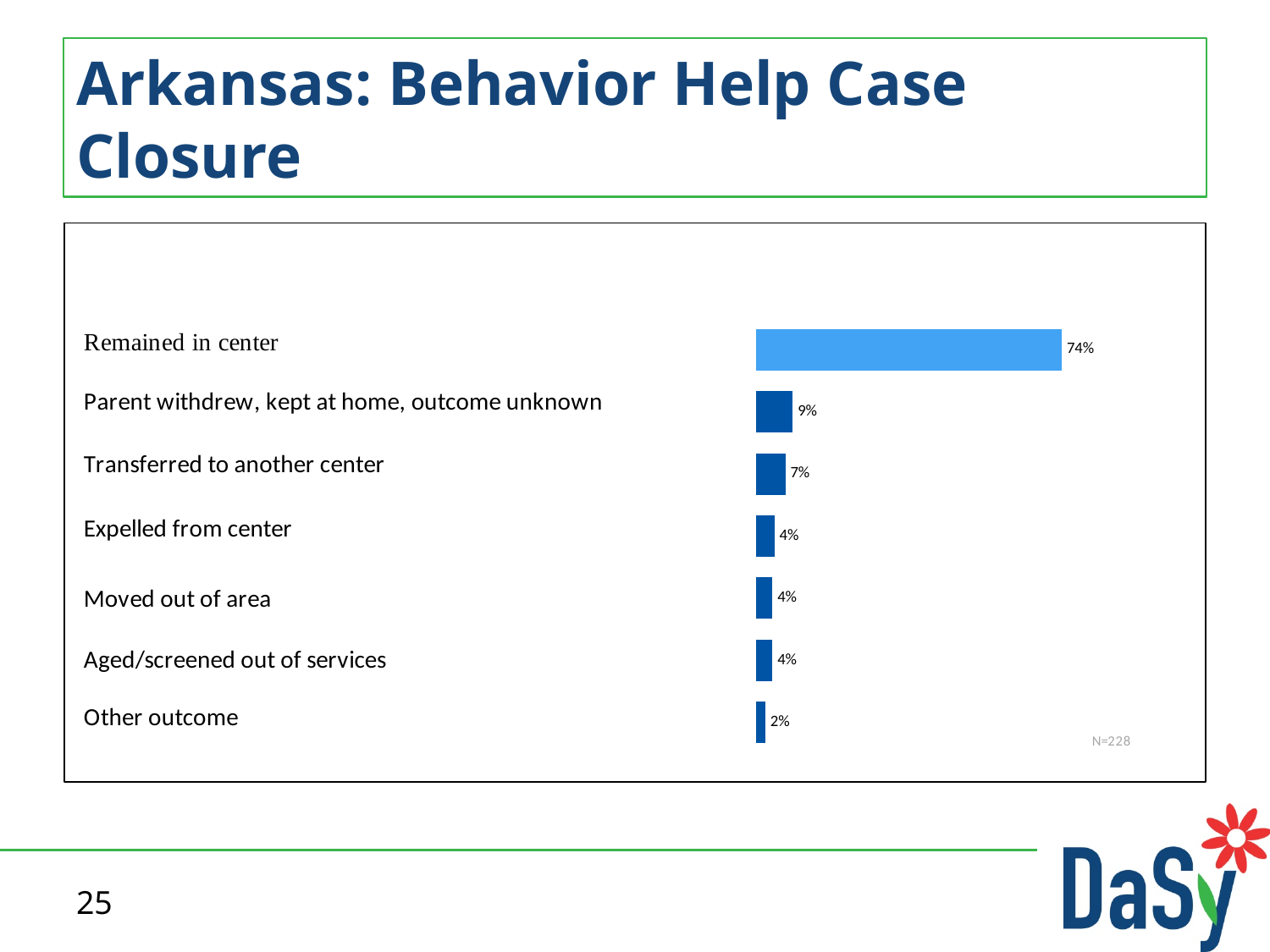
What sample size (N) is noted on the chart? N=228 Which category has the lowest value? Other outcome What is the value for 'Parent withdrew, kept at home, outcome unknown'? 9% What is the value for 'Other outcome'? 2% What kind of chart is shown on the slide? Bar chart How many categories are shown in the chart? 7 Which category has the highest value? Remained in center Which is larger, 'Transferred to another center' or 'Moved out of area'? Transferred to another center What is the difference between 'Remained in center' and 'Parent withdrew, kept at home, outcome unknown'? 65% What percentage of cases remained in center? 74% What percentage of cases were transferred to another center? 7% What is the difference between 'Transferred to another center' and 'Expelled from center'? 3%